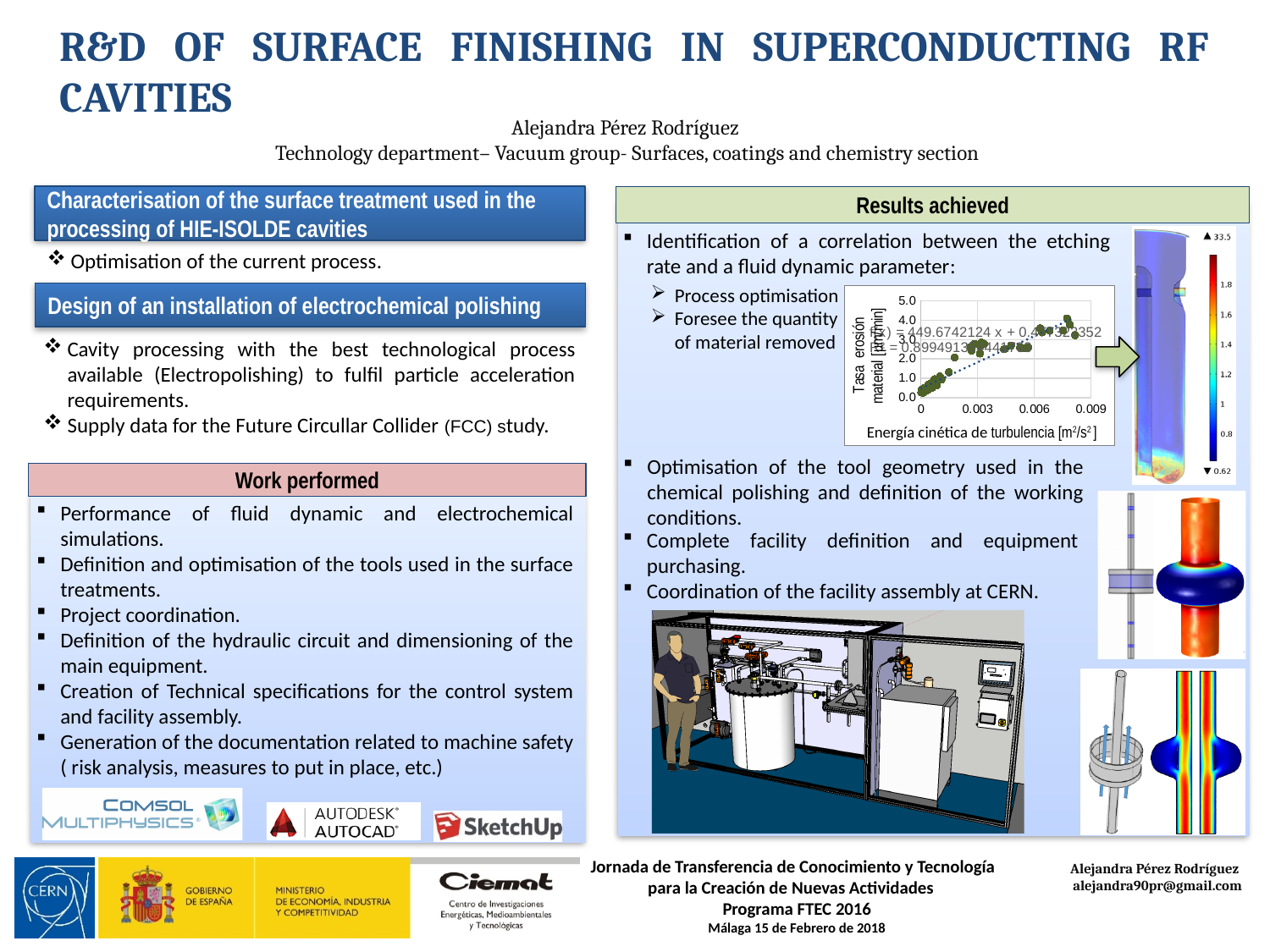
What is the label of the y axis of the scatter chart? Tasa erosión material [µm/min] Do the plotted points in the scatter chart rise or fall as the turbulence kinetic energy increases? rise What is the highest tick value shown on the y axis of the scatter chart? 5.0 What is the label of the x axis of the scatter chart? Energía cinética de turbulencia [m²/s²] What is the slope coefficient of x in the trendline equation shown on the scatter chart? 449.6742124 What is the highest tick value shown on the x axis of the scatter chart? 0.009 What kind of chart is shown in the Results achieved section? scatter chart Is the erosion rate of the points at the lowest turbulence kinetic energy (near 0) greater or less than 1.0? less Is the erosion rate of the points at the highest turbulence kinetic energy (near 0.009) greater or less than 3.0? greater